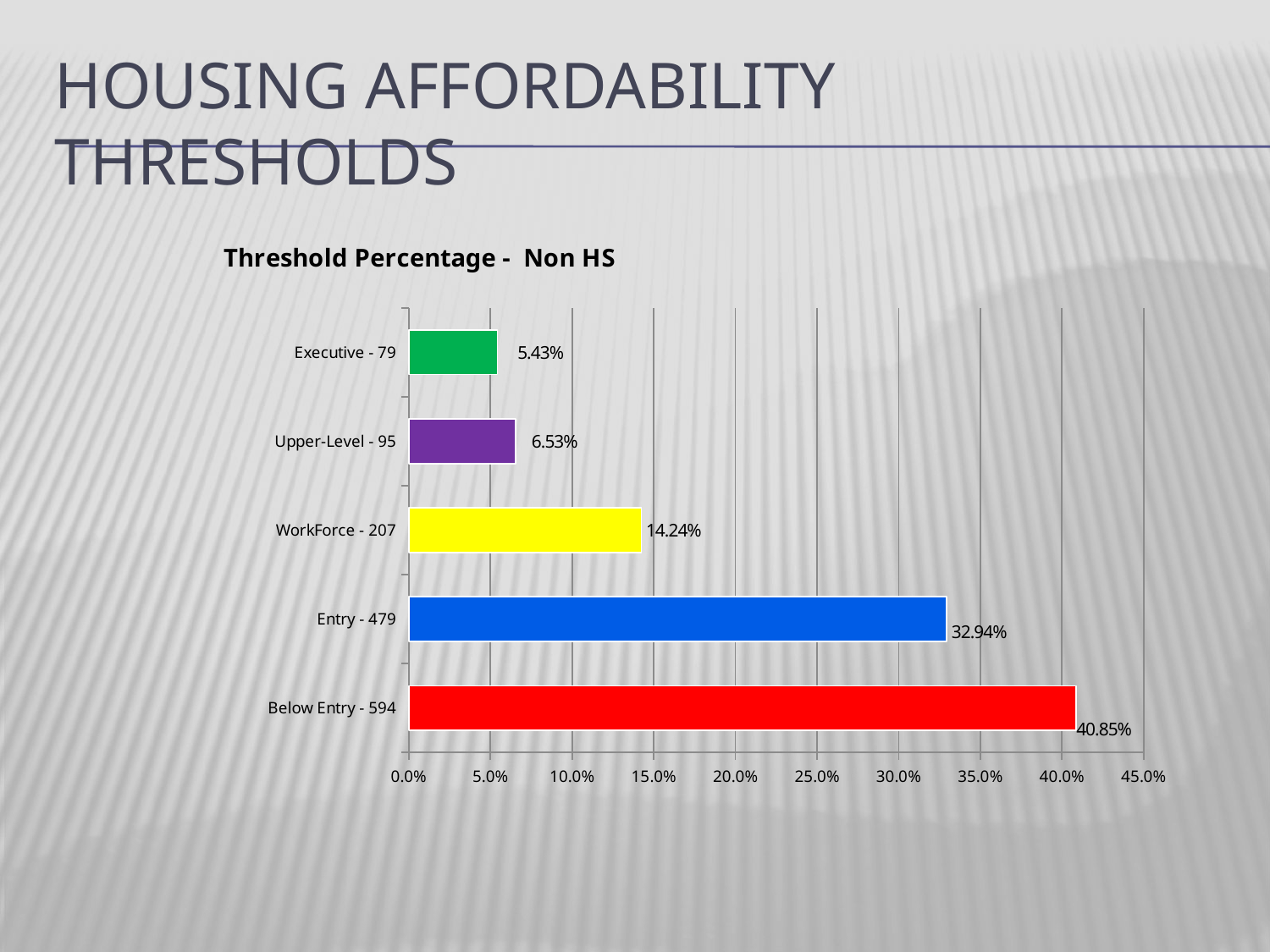
What kind of chart is shown on the slide? bar chart What is the difference between the values for Below Entry - 594 and Entry - 479? 7.91% Which category has the lowest value? Executive - 79 Is the value for Entry - 479 greater or less than 30.0%? greater Which category has the highest value? Below Entry - 594 How many categories are shown in the chart? 5 What is the value for WorkForce - 207? 14.24% Which is larger, the value for Upper-Level - 95 or the value for WorkForce - 207? WorkForce - 207 What colour is the bar for Entry - 479? blue What is the title of the chart? Threshold Percentage - Non HS What is the value for Below Entry - 594? 40.85% What is the value for Executive - 79? 5.43%